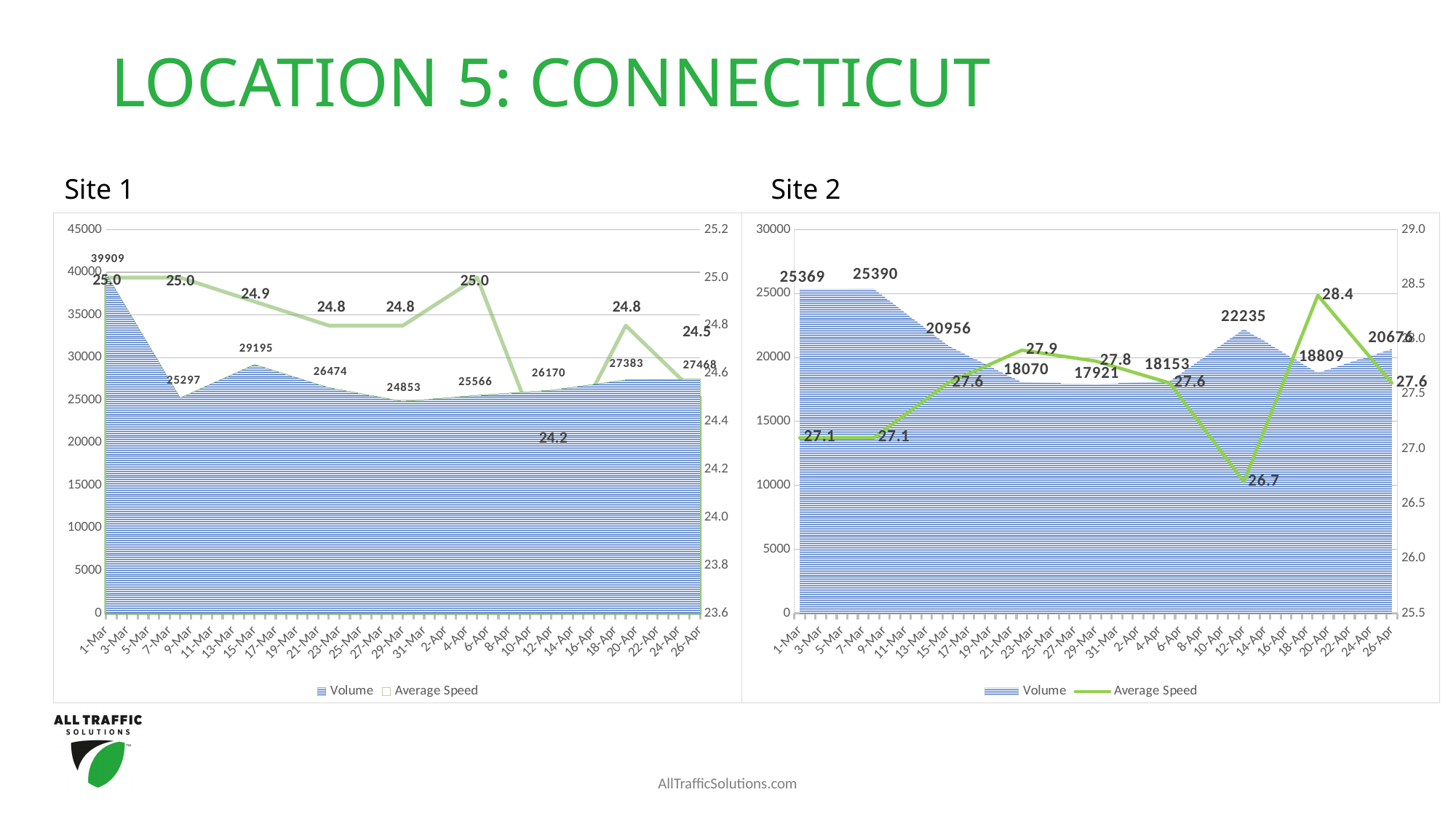
In the Site 2 chart, what is the highest Average Speed value labelled? 28.4 In the Site 2 chart, what is the lowest Volume value labelled? 17921 How many series does the legend of the Site 2 chart list? 2 Which chart has the larger Volume at its first data point (1-Mar), Site 1 or Site 2? Site 1 In the Site 1 chart, what is the difference between the highest and lowest labelled Volume values? 15056 In the Site 1 chart, what is the lowest Average Speed value labelled? 24.2 In the Site 1 chart, what is the Volume value labelled at the first data point (1-Mar)? 39909 In the Site 2 chart, what is the Average Speed value labelled at the last data point (26-Apr)? 27.6 In the Site 1 chart, what is the highest Volume value labelled? 39909 In the Site 2 chart, what is the difference between the highest and lowest labelled Average Speed values? 1.7 In the Site 2 chart, what is the lowest Average Speed value labelled? 26.7